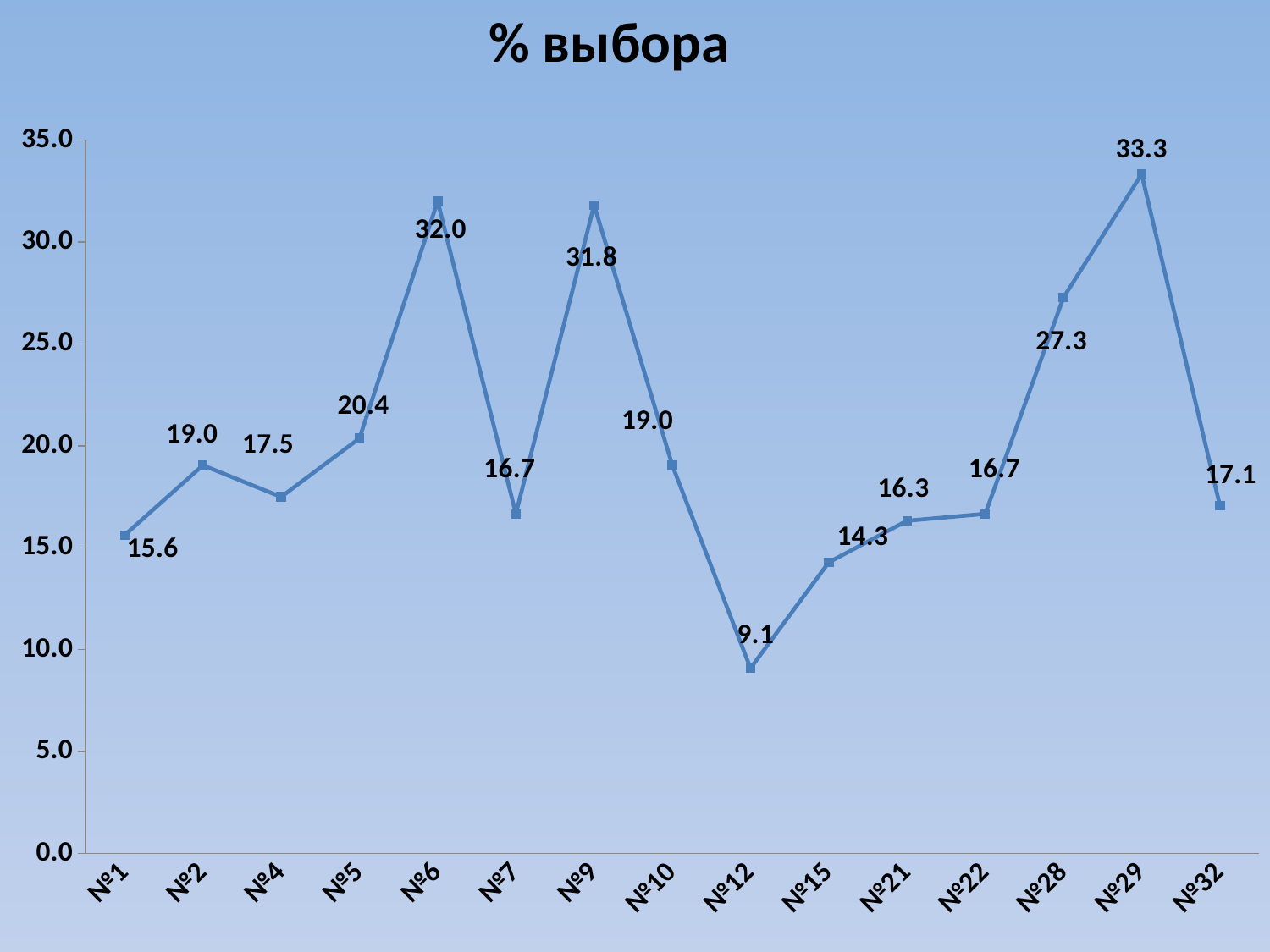
What is the difference between the values for №5 and №4? 2.9 Which is larger, the value for №10 or the value for №15? №10 What type of chart is shown on the slide? line chart How many categories are plotted on the x axis? 15 Which category has the highest value? №29 Do the values rise or fall from №22 to №29? rise What is the difference between the values for №29 and №12? 24.2 Which category has the lowest value? №12 What is the value for №12? 9.1 What is the value for №28? 27.3 What is the value for №6? 32.0 What is the title of the chart? % выбора